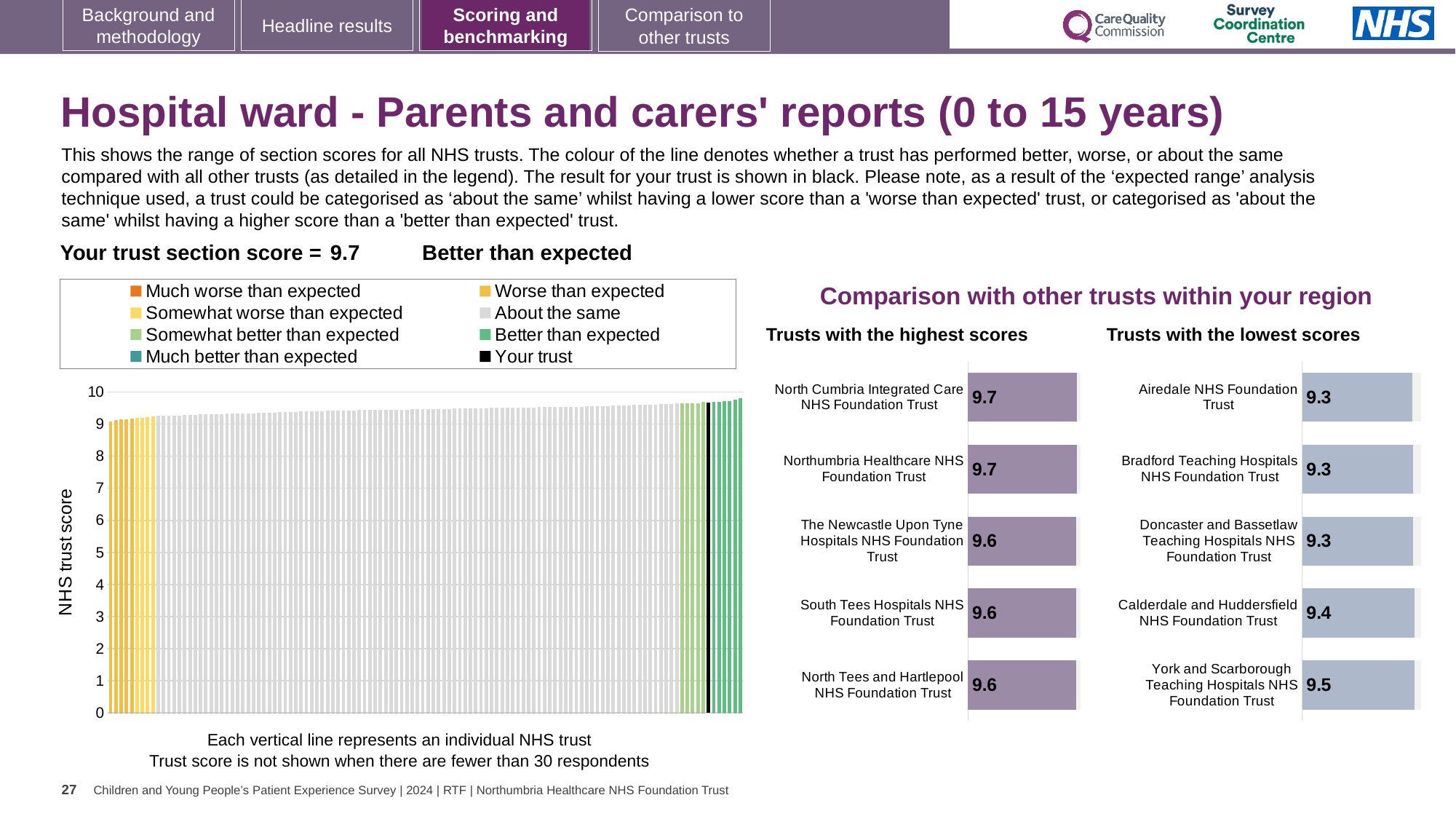
How many trusts are shown in the 'Trusts with the highest scores' chart? 5 In the 'Trusts with the lowest scores' chart, which trust has the highest score? York and Scarborough Teaching Hospitals NHS Foundation Trust In the 'Trusts with the lowest scores' chart, what is the difference between the scores of York and Scarborough Teaching Hospitals NHS Foundation Trust and Airedale NHS Foundation Trust? 0.2 In the 'Trusts with the highest scores' chart, what is the score for South Tees Hospitals NHS Foundation Trust? 9.6 How many entries does the legend of the NHS trust score chart list? 8 In the 'Trusts with the lowest scores' chart, which has the larger score: Calderdale and Huddersfield NHS Foundation Trust or Bradford Teaching Hospitals NHS Foundation Trust? Calderdale and Huddersfield NHS Foundation Trust In the 'Trusts with the lowest scores' chart, what is the score for Calderdale and Huddersfield NHS Foundation Trust? 9.4 What is the title of the section containing the two small bar charts on the right? Comparison with other trusts within your region What kind of chart is the 'NHS trust score' chart on the left? Bar chart In the 'NHS trust score' chart, is the value of the leftmost bar greater or less than 8? greater In the 'NHS trust score' chart, do the bars rise or fall from left to right? Rise In the 'Trusts with the highest scores' chart, what is the score for North Cumbria Integrated Care NHS Foundation Trust? 9.7